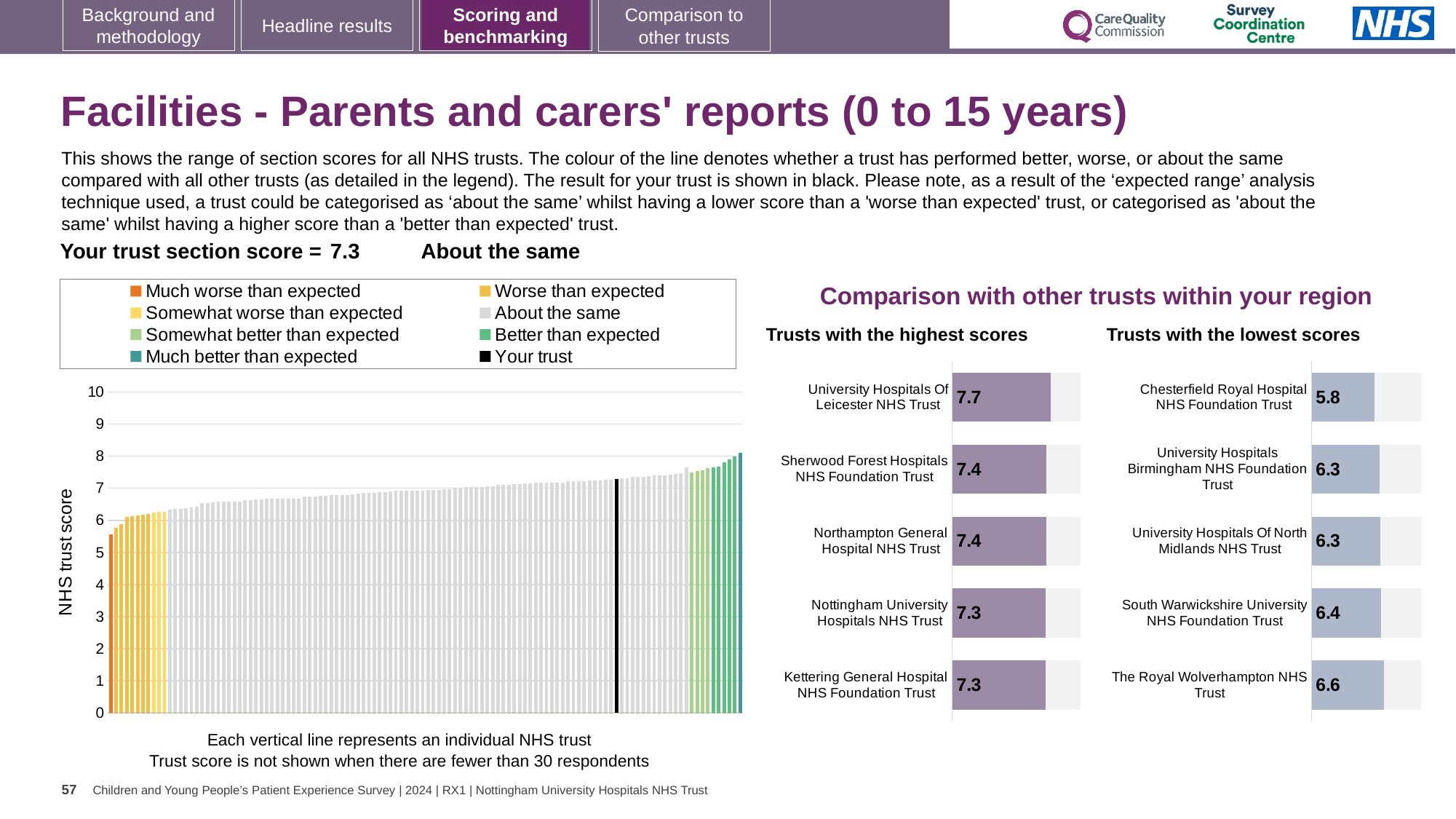
How many trusts are listed in the 'Trusts with the highest scores' chart? 5 In the 'Trusts with the highest scores' chart, what is the score for University Hospitals Of Leicester NHS Trust? 7.7 In the 'Trusts with the lowest scores' chart, what is the score for Chesterfield Royal Hospital NHS Foundation Trust? 5.8 In the large chart on the left showing all NHS trusts, is the value for the black 'Your trust' bar greater or less than 7? greater In the 'Trusts with the highest scores' chart, which trust has the highest score? University Hospitals Of Leicester NHS Trust In the 'Trusts with the lowest scores' chart, what is the score for The Royal Wolverhampton NHS Trust? 6.6 In the 'Trusts with the highest scores' chart, what is the score for Kettering General Hospital NHS Foundation Trust? 7.3 How many entries does the legend of the large chart on the left list? 8 In the 'Trusts with the lowest scores' chart, which has the higher score: The Royal Wolverhampton NHS Trust or South Warwickshire University NHS Foundation Trust? The Royal Wolverhampton NHS Trust In the 'Trusts with the highest scores' chart, what is the difference between the scores of University Hospitals Of Leicester NHS Trust and Kettering General Hospital NHS Foundation Trust? 0.4 In the 'Trusts with the lowest scores' chart, what is the difference between the scores of The Royal Wolverhampton NHS Trust and Chesterfield Royal Hospital NHS Foundation Trust? 0.8 In the 'Trusts with the lowest scores' chart, which trust has the lowest score? Chesterfield Royal Hospital NHS Foundation Trust